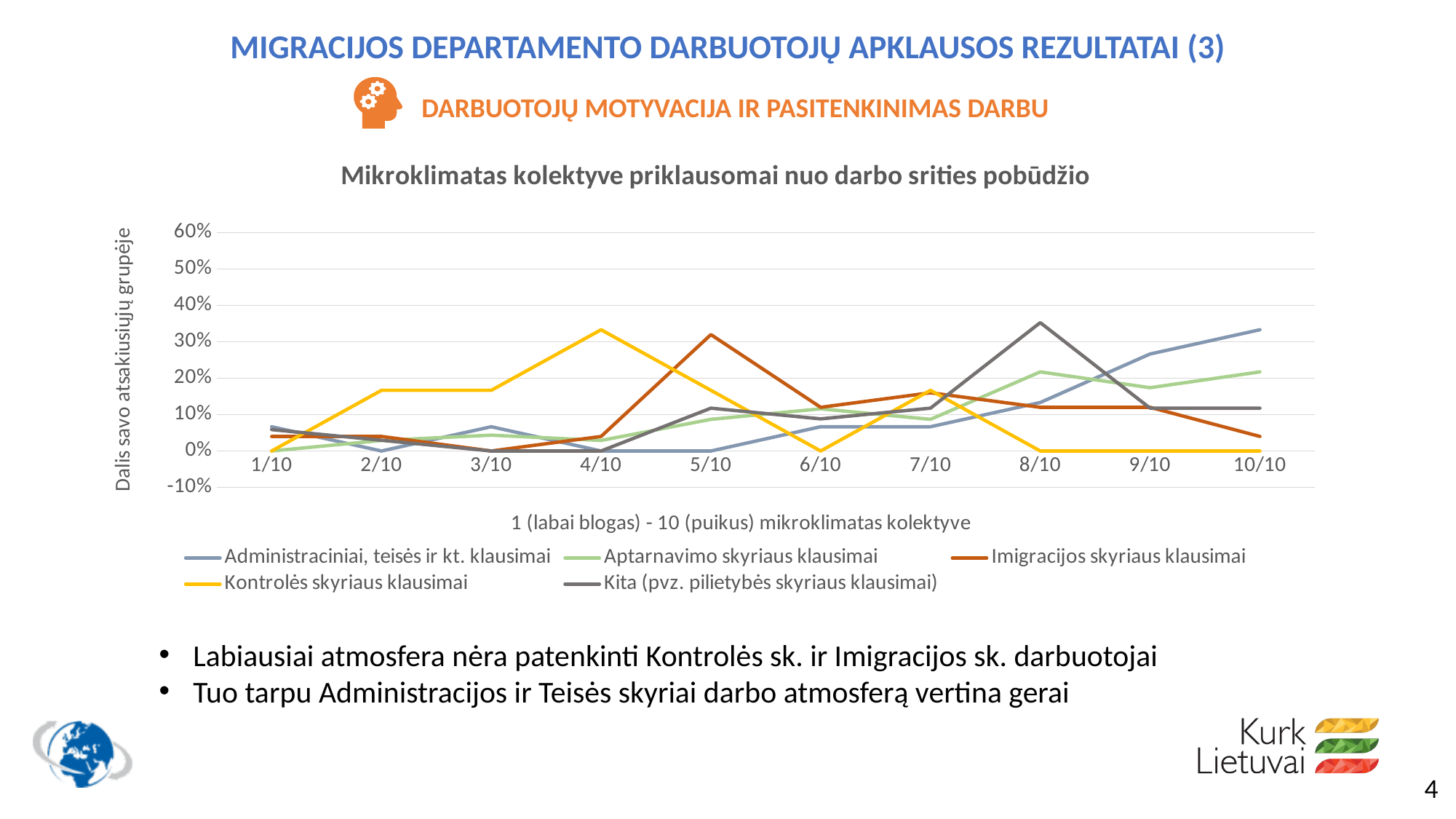
Which series has the highest value at 8/10? Kita (pvz. pilietybės skyriaus klausimai) Does the value for Administraciniai, teisės ir kt. klausimai rise or fall from 7/10 to 10/10? rise Which series has the highest value at 10/10? Administraciniai, teisės ir kt. klausimai What is the title of the chart? Mikroklimatas kolektyve priklausomai nuo darbo srities pobūdžio What is the label of the y axis? Dalis savo atsakiusiųjų grupėje Is the value for Kontrolės skyriaus klausimai at 4/10 greater or less than 20%? greater How many series does the legend list? 5 At 10/10, which is larger: Administraciniai, teisės ir kt. klausimai or Aptarnavimo skyriaus klausimai? Administraciniai, teisės ir kt. klausimai How many points are there along the x axis? 10 What kind of chart is shown on the slide? line chart Is the value for Kontrolės skyriaus klausimai at 8/10 greater or less than 10%? less Which series has the highest value at 4/10? Kontrolės skyriaus klausimai